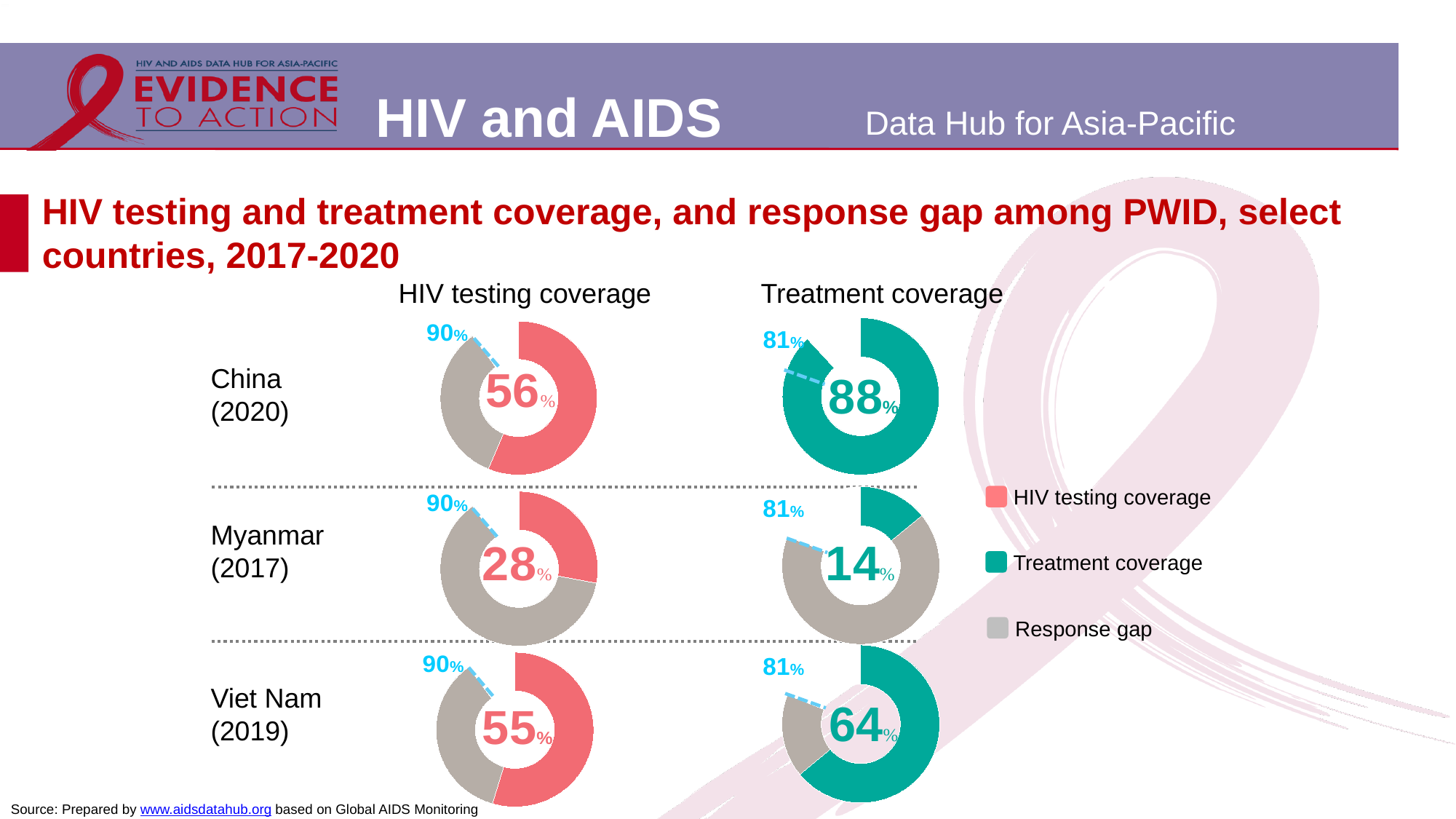
What is the treatment coverage for China (2020)? 88% How many countries are shown on the slide? 3 What is the difference between the treatment coverage of China (2020) and Viet Nam (2019)? 24% Which country has the lowest HIV testing coverage? Myanmar (2017) What is the treatment coverage for Myanmar (2017)? 14% What kind of chart is used to show the coverage values? Donut (pie) chart What target value is marked on each treatment coverage donut? 81% Which is larger for Myanmar (2017): HIV testing coverage or treatment coverage? HIV testing coverage What target value is marked on each HIV testing coverage donut? 90% What is the HIV testing coverage for Viet Nam (2019)? 55% What is the HIV testing coverage for China (2020)? 56% Which country has the highest treatment coverage? China (2020)